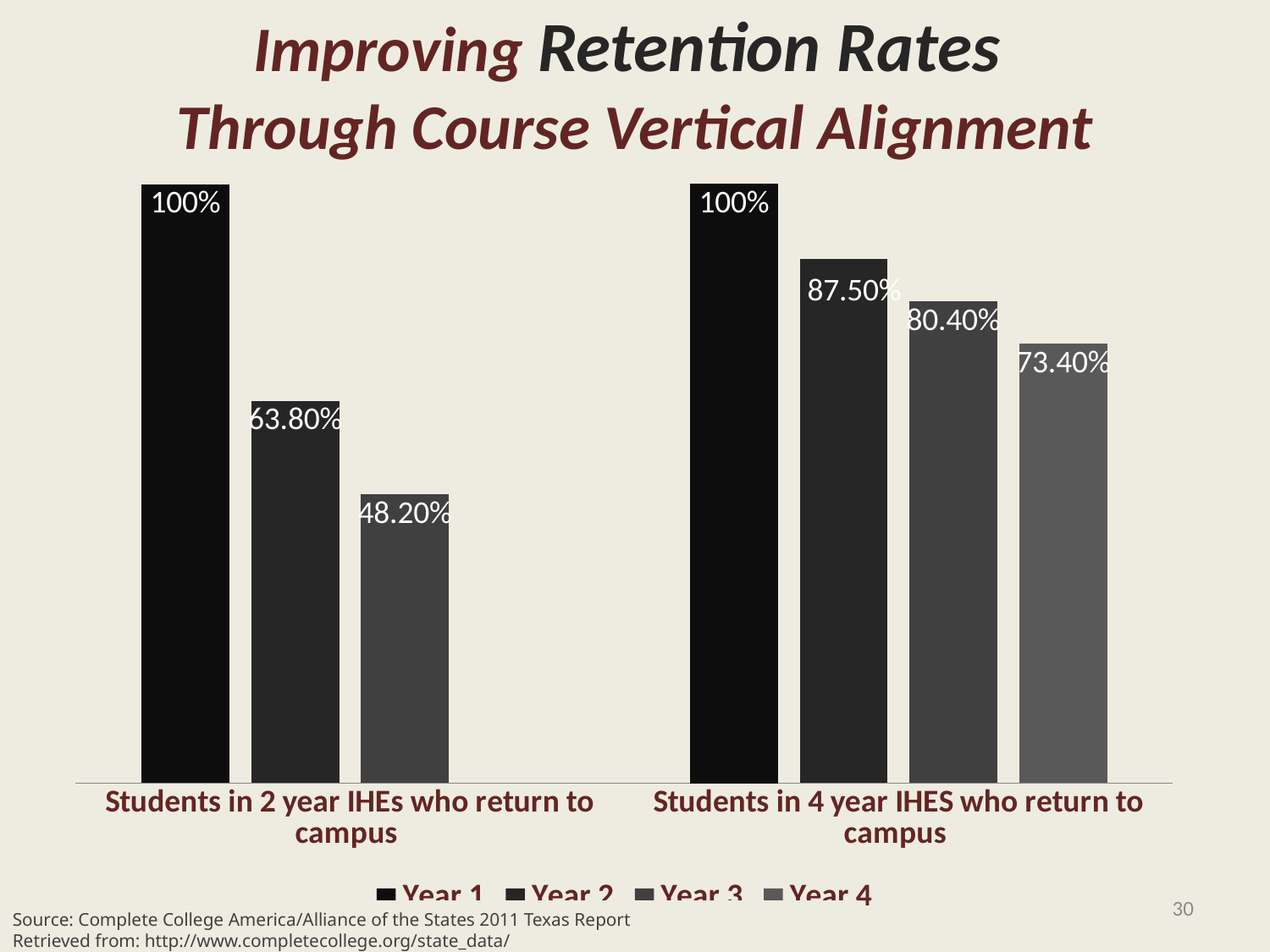
Which year has the lowest value for Students in 2 year IHEs who return to campus? Year 3 How many series does the legend list? 4 What is the difference between the Year 2 values for 4 year IHES and 2 year IHEs? 23.70% What is the Year 2 value for Students in 4 year IHES who return to campus? 87.50% What kind of chart is shown on the slide? Bar chart What is the Year 3 value for Students in 2 year IHEs who return to campus? 48.20% What is the Year 3 value for Students in 4 year IHES who return to campus? 80.40% Do the values for Students in 4 year IHES who return to campus rise or fall from Year 1 to Year 4? Fall What is the Year 4 value for Students in 4 year IHES who return to campus? 73.40% Which year has the lowest value for Students in 4 year IHES who return to campus? Year 4 Which is larger: the Year 3 value for 2 year IHEs or the Year 3 value for 4 year IHES? 4 year IHES What is the Year 2 value for Students in 2 year IHEs who return to campus? 63.80%